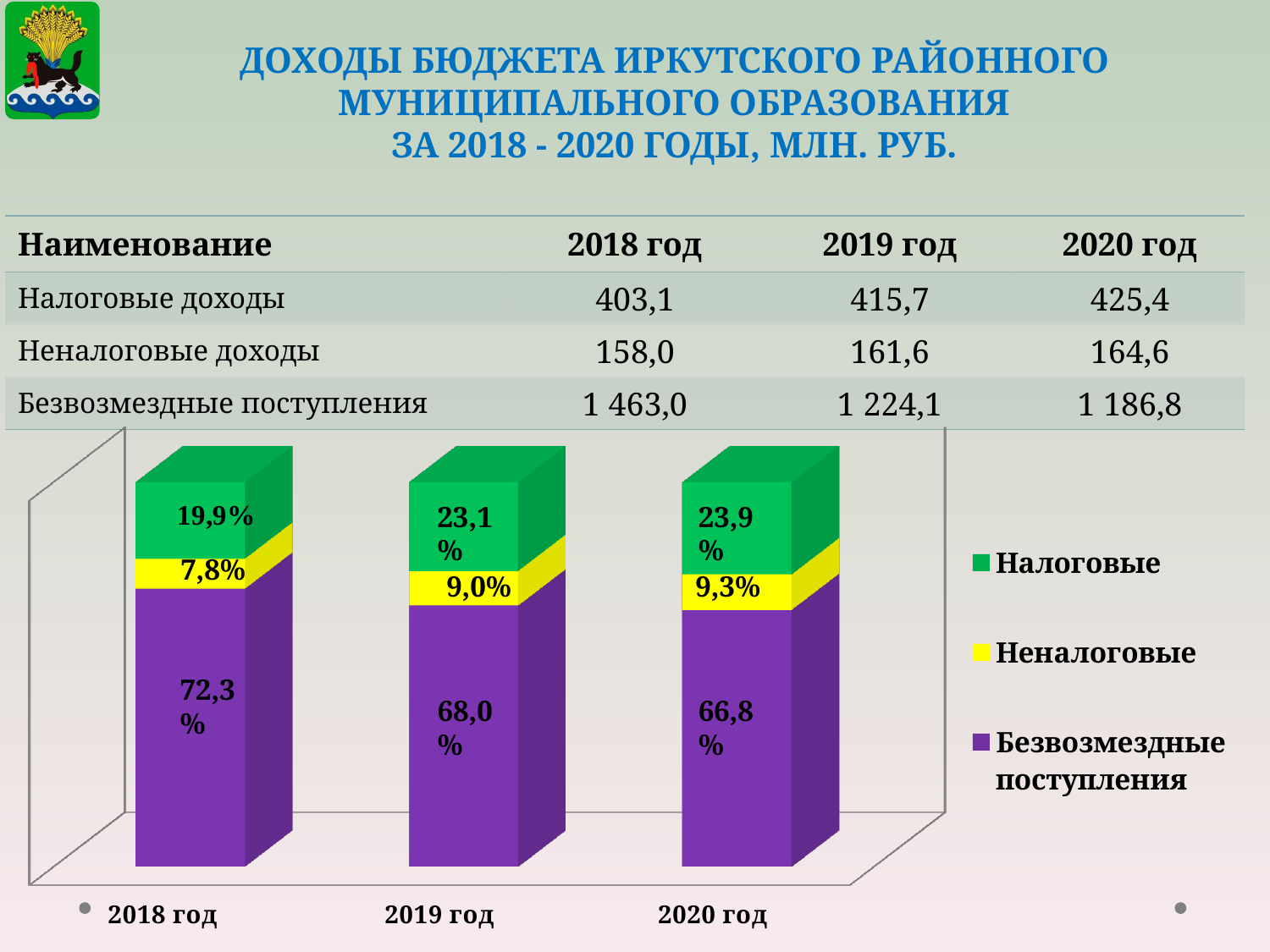
How many series does the chart legend list? 3 What is the share of Безвозмездные поступления in 2018 год according to the chart? 72,3% What type of chart is shown on the slide? stacked bar chart How many years (categories) are shown on the x axis of the chart? 3 Which colour represents Неналоговые in the chart? yellow What is the share of Неналоговые in 2019 год according to the chart? 9,0% In which year is the share of Неналоговые the lowest? 2018 год What is the difference between the share of Безвозмездные поступления in 2018 год and in 2020 год? 5,5% Which is larger: the share of Налоговые in 2019 год or in 2020 год? 2020 год In which year is the share of Безвозмездные поступления the highest? 2018 год Does the share of Налоговые rise or fall from 2018 год to 2020 год? rise What is the share of Налоговые in 2020 год according to the chart? 23,9%